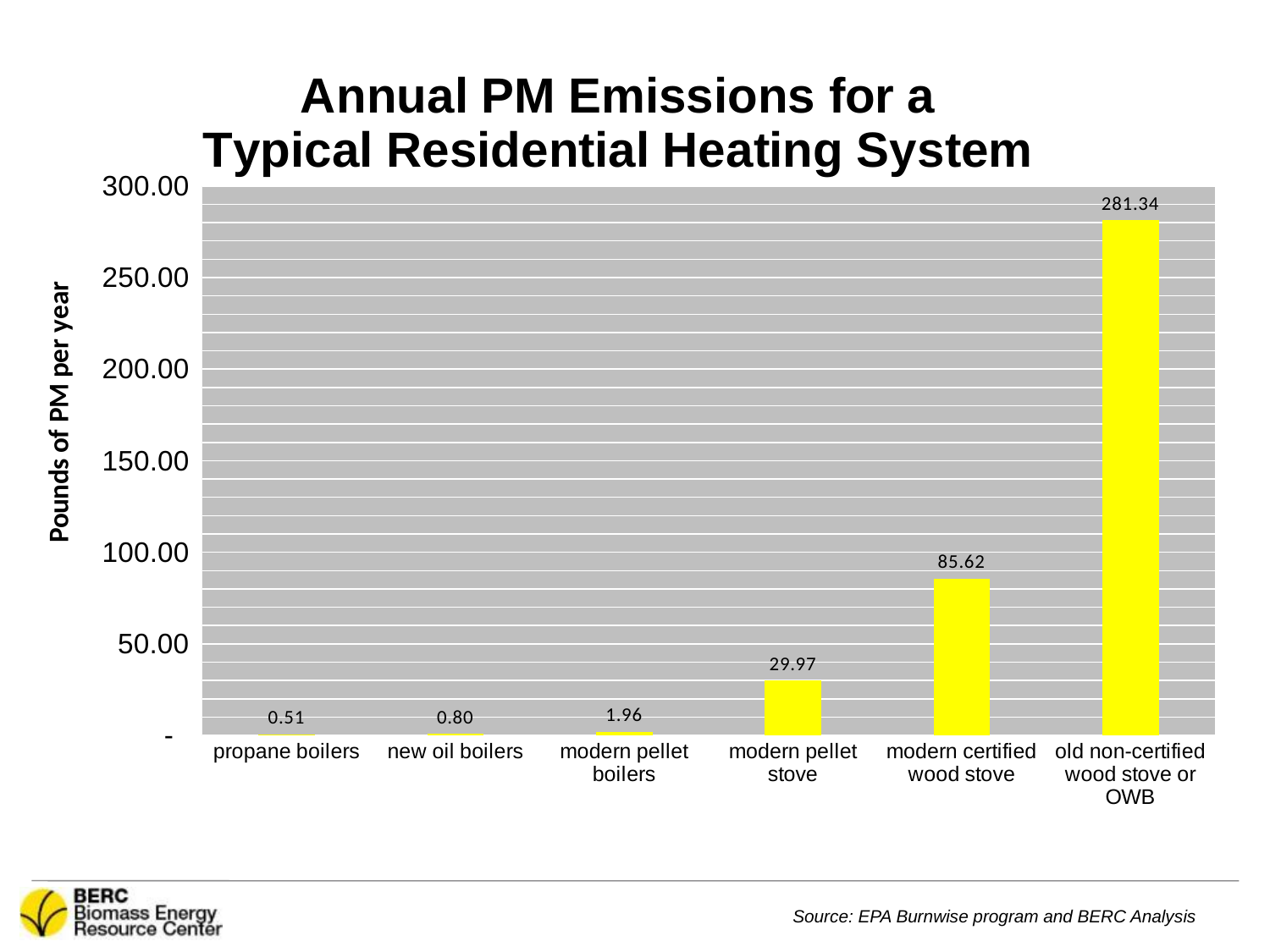
What type of chart is shown on the slide? bar chart Is the value for old non-certified wood stove or OWB greater or less than 250.00? greater What is the annual PM emissions value for modern certified wood stove? 85.62 Which heating system has the highest annual PM emissions? old non-certified wood stove or OWB How many heating system categories are shown in the chart? 6 What is the label of the y-axis? Pounds of PM per year What is the annual PM emissions value for modern pellet stove? 29.97 Which has higher annual PM emissions, modern pellet boilers or modern pellet stove? modern pellet stove What is the difference in annual PM emissions between old non-certified wood stove or OWB and modern certified wood stove? 195.72 Which heating system has the lowest annual PM emissions? propane boilers What is the annual PM emissions value for new oil boilers? 0.80 What is the annual PM emissions value for propane boilers? 0.51